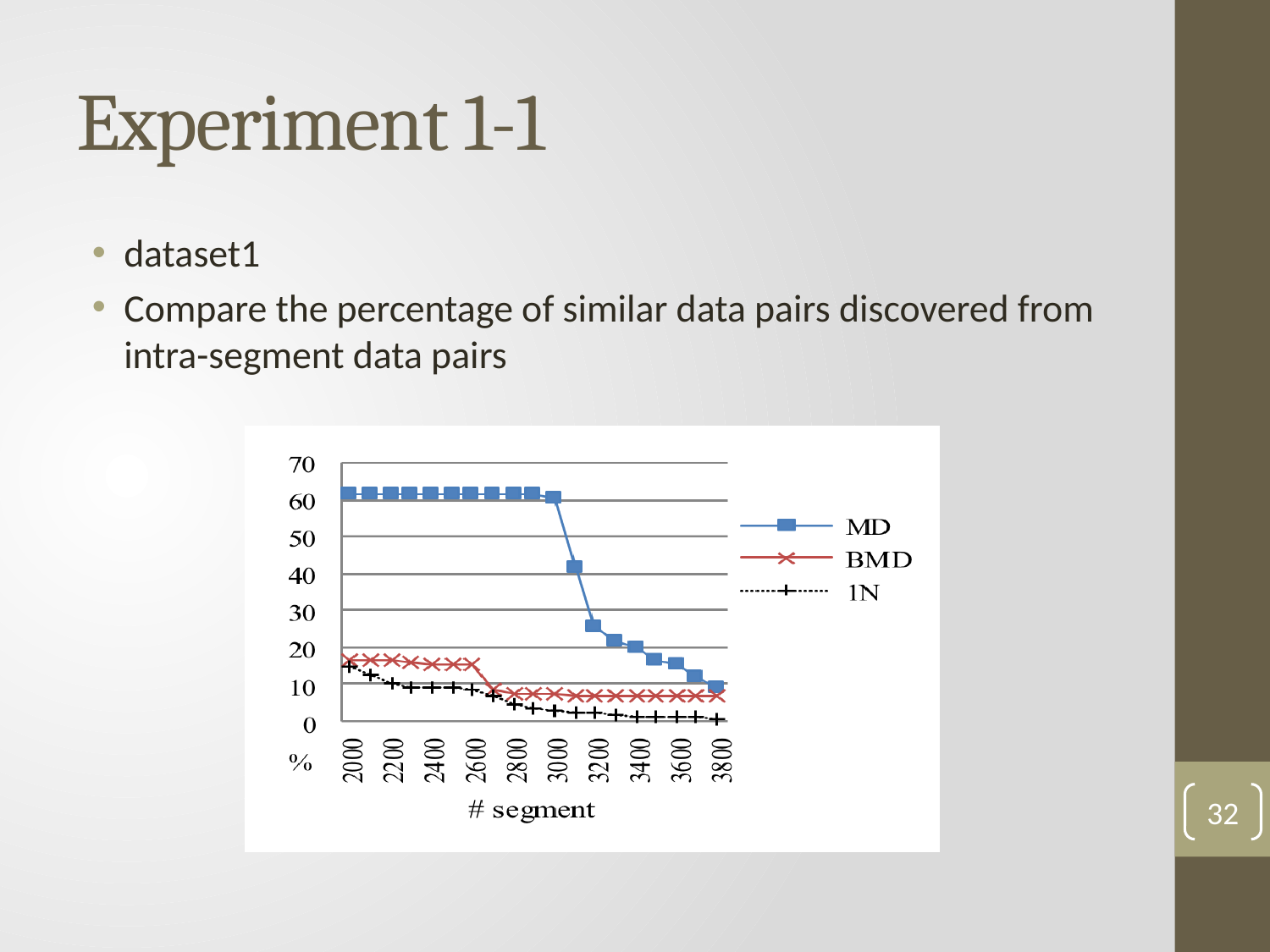
At 3800 segments, which series has the larger value, BMD or 1N? BMD Is the value for BMD at 2000 segments greater or less than 10? greater Is the value for MD at 3800 segments greater or less than 20? less What kind of chart is shown on the slide? line chart Is the value for 1N at 3800 segments greater or less than 10? less What is the x-axis title of the chart? # segment At 2000 segments, which series has the larger value, MD or BMD? MD Does the MD series rise or fall as # segment increases from 2000 to 3800? fall Which series are listed in the chart's legend? MD, BMD, 1N How many series does the chart's legend list? 3 Does the 1N series rise or fall as # segment increases from 2000 to 3800? fall